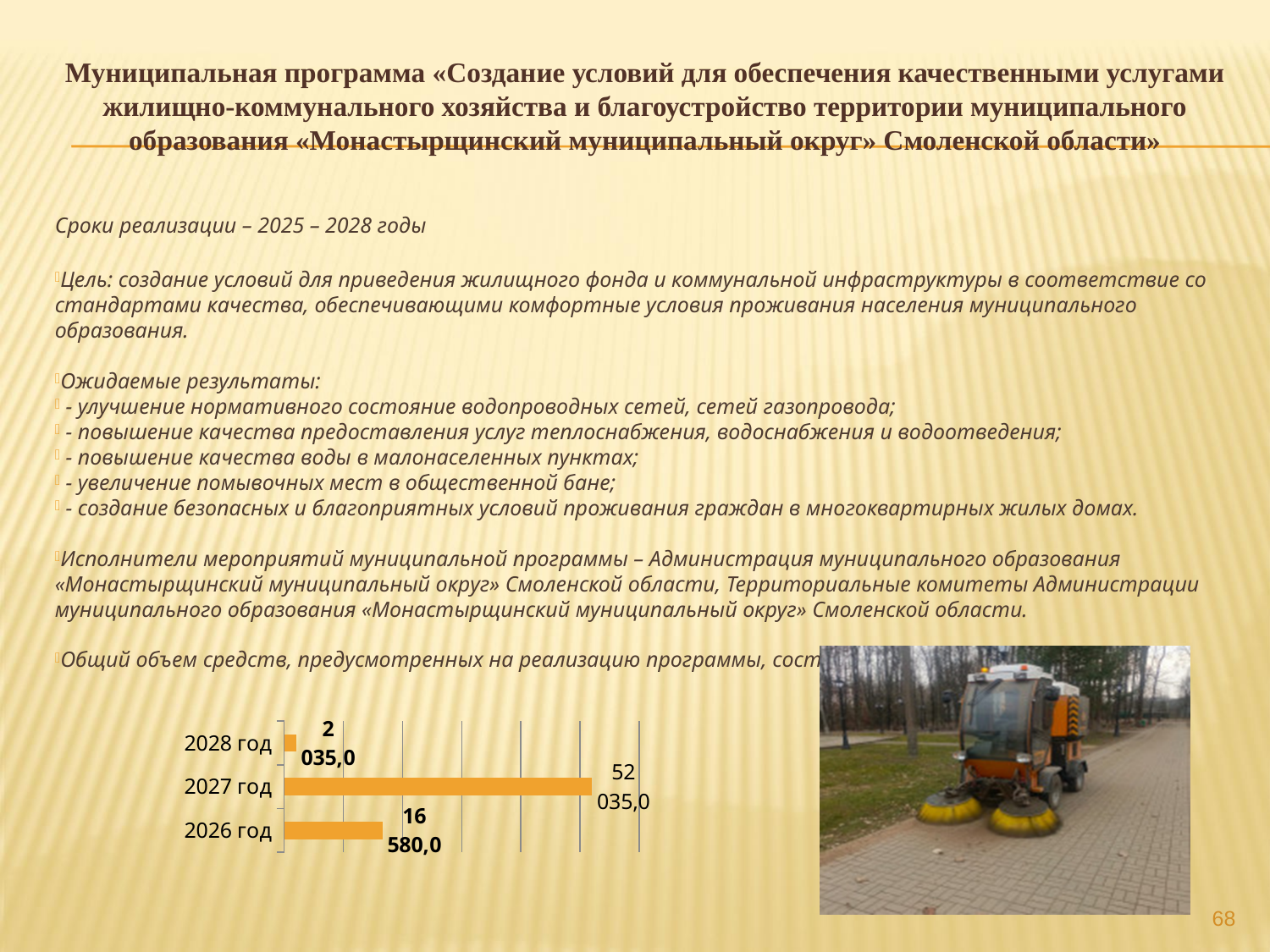
What colour are the bars in the chart? orange What kind of chart is shown on the slide? bar chart How many categories (years) does the chart show? 3 Which year has the highest value? 2027 год What is the value for 2026 год? 16 580,0 What is the total of the values for 2026 год, 2027 год and 2028 год? 70 650,0 What is the value for 2027 год? 52 035,0 What is the difference between the values for 2027 год and 2026 год? 35 455,0 What is the difference between the values for 2026 год and 2028 год? 14 545,0 What is the value for 2028 год? 2 035,0 Which is larger, the value for 2026 год or for 2028 год? 2026 год Which year has the lowest value? 2028 год